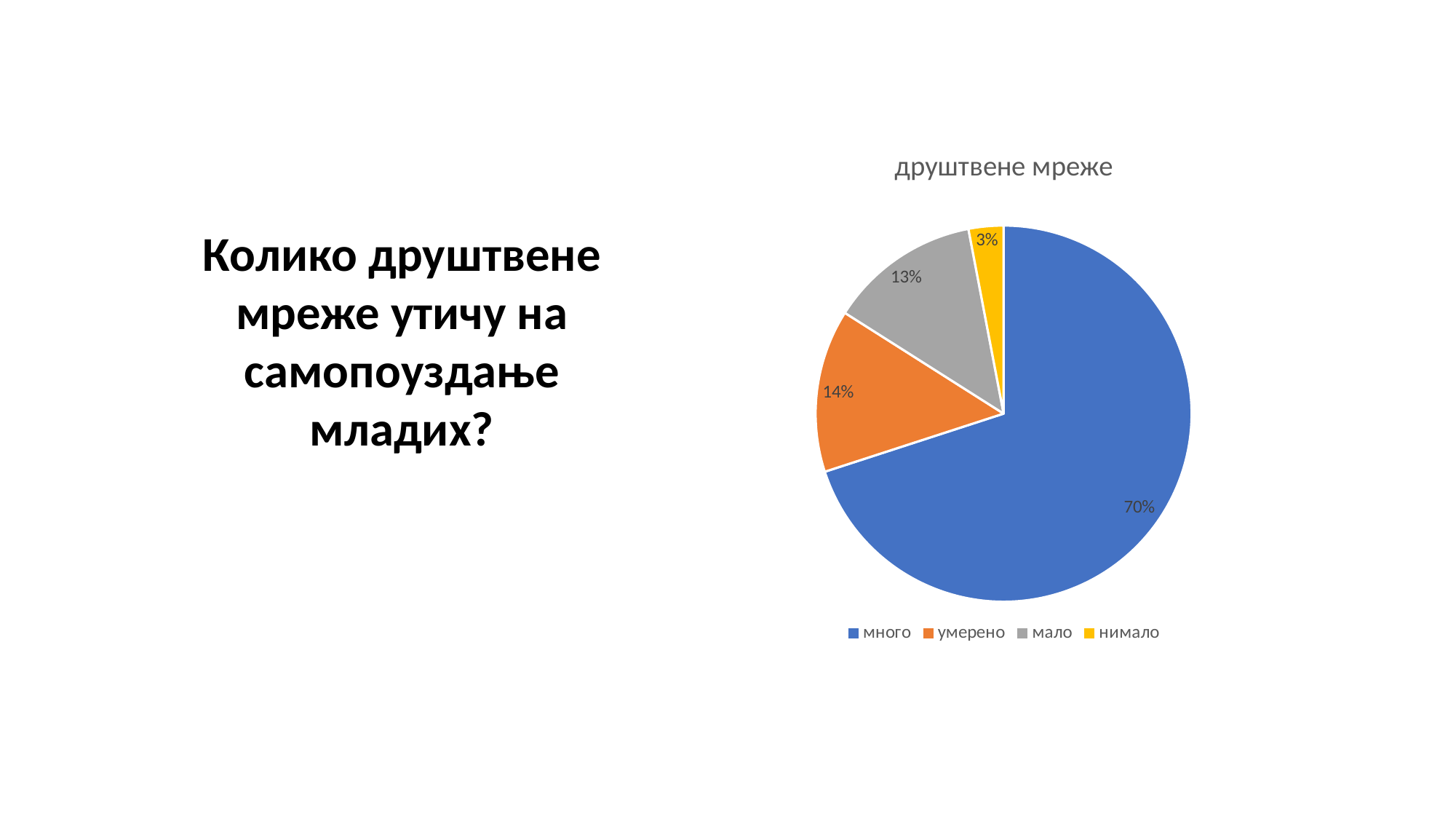
What is the difference in percentage points between the 'много' and 'умерено' slices? 56 What is the title of the chart? друштвене мреже Which category has the largest slice of the pie? много What share of the pie does the 'умерено' slice represent? 14% Which category has the smallest slice of the pie? нимало What share of the pie does the 'мало' slice represent? 13% What share of the pie does the 'много' slice represent? 70% How many categories does the legend list? 4 What kind of chart is shown on the slide? pie chart What share of the pie does the 'нимало' slice represent? 3% What colour is the 'умерено' slice? orange Which slice is larger, 'мало' or 'нимало'? мало